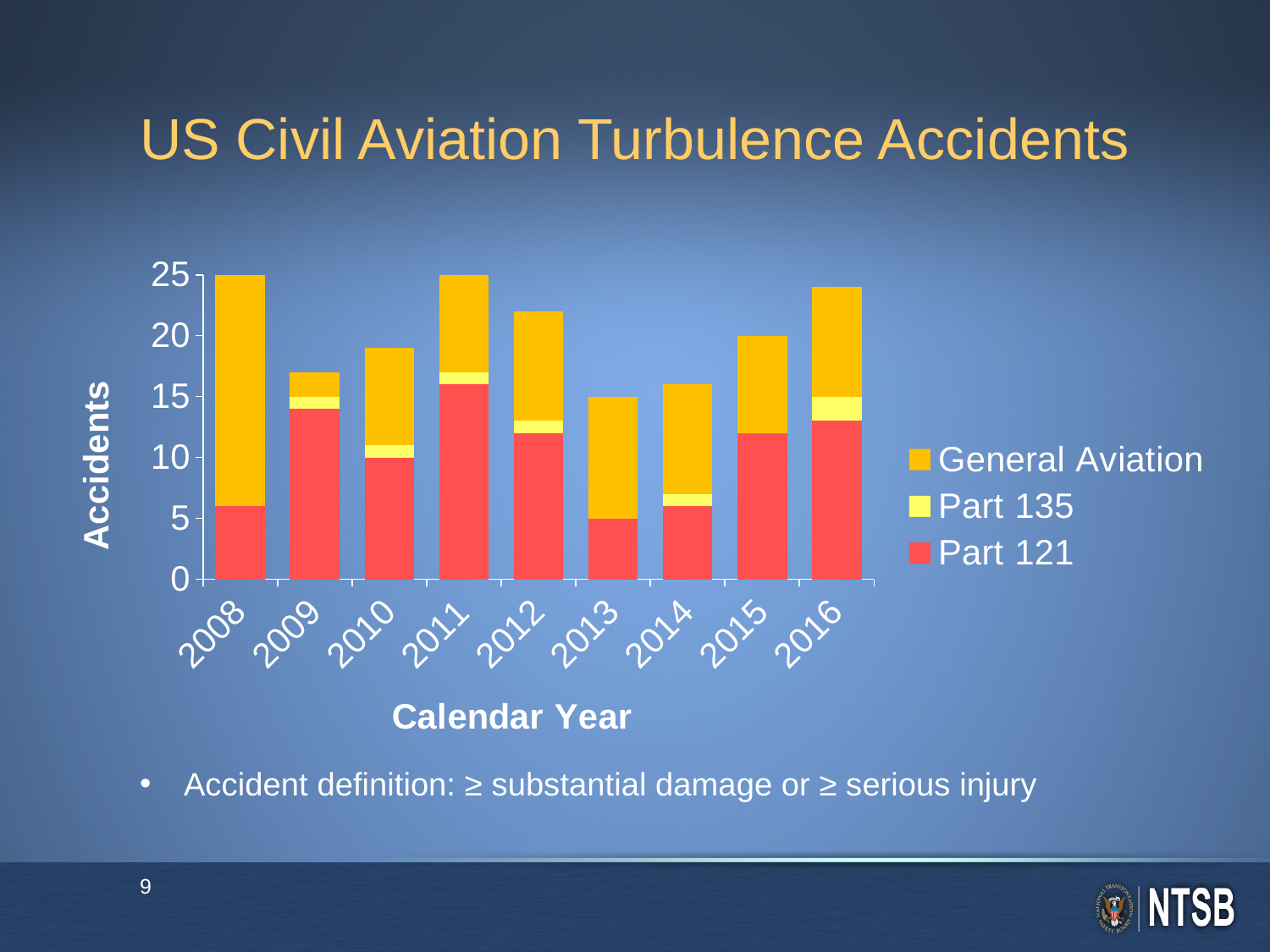
Is the total number of accidents for 2016 greater or less than 20? greater How many calendar years are shown on the x axis? 9 How many series does the legend list? 3 What is the total number of accidents for 2015? 20 What is the total number of accidents for 2013? 15 What is the total number of accidents for 2008? 25 Which year has more total accidents, 2016 or 2013? 2016 What kind of chart is shown on the slide? bar chart Is the total number of accidents for 2012 greater or less than 20? greater What is the label on the y axis? Accidents Is the total number of accidents for 2009 greater or less than 20? less Which year has more total accidents, 2008 or 2009? 2008